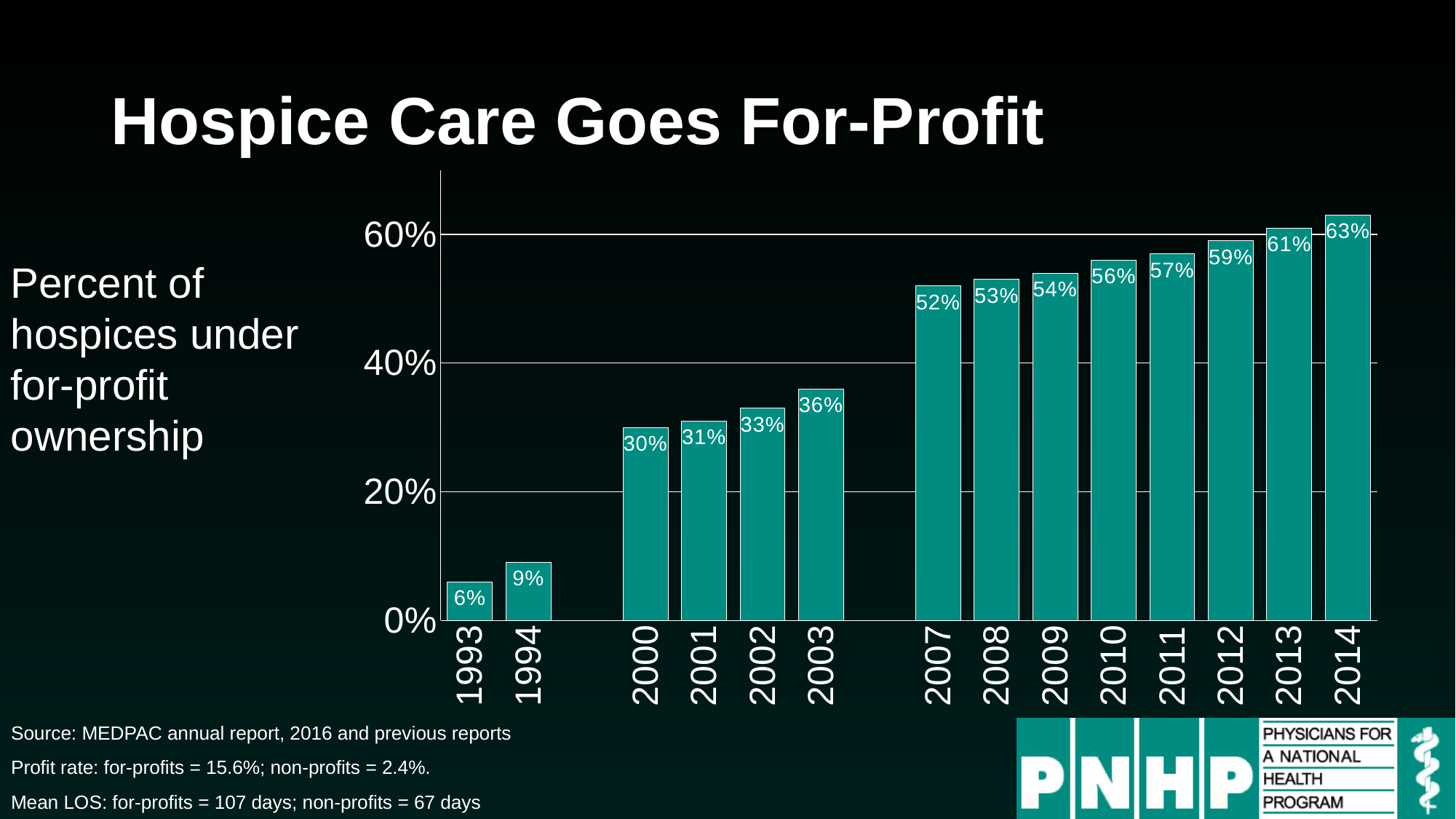
How many years are shown on the x axis? 16 Which year has the lowest percent of for-profit hospices? 1993 What is the difference between the values for 2014 and 1993? 57 percentage points Which year has the highest percent of for-profit hospices? 2014 What is the value shown for 2003? 36% Which year has a larger value, 2001 or 2008? 2008 Is the value for 2012 greater or less than 40%? greater What percent of hospices were under for-profit ownership in 1993? 6% Do the values rise or fall from 1993 to 2014? Rise What kind of chart is shown on the slide? Bar chart What is the value shown for 2010? 56% What is the difference between the values for 2007 and 2003? 16 percentage points